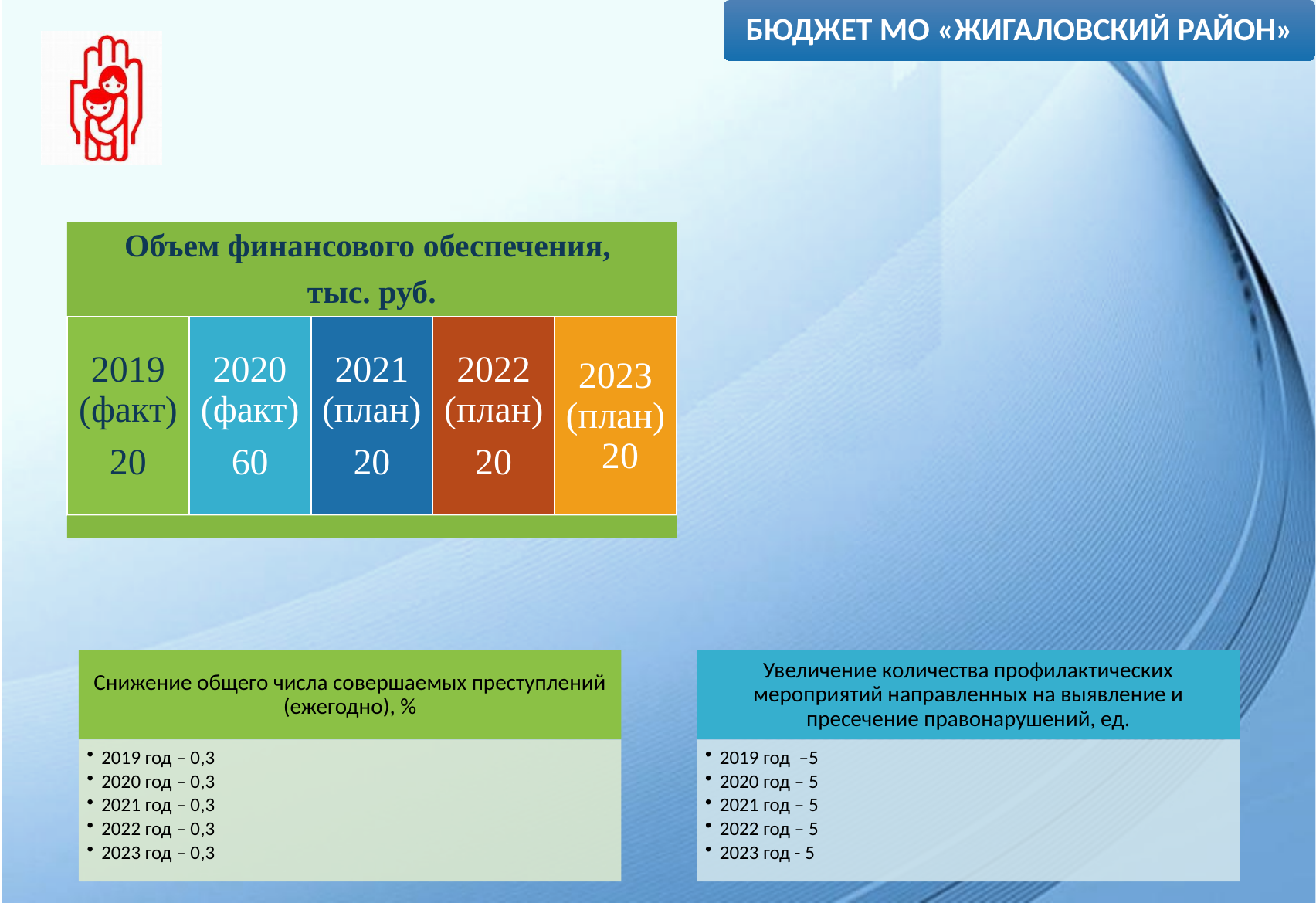
In the chart titled «Объем финансового обеспечения, тыс. руб.», what is the total of the values across all five years? 140 How many year categories are shown in the chart titled «Объем финансового обеспечения, тыс. руб.»? 5 In the chart titled «Объем финансового обеспечения, тыс. руб.», what is the value for 2020 (факт)? 60 In the chart titled «Объем финансового обеспечения, тыс. руб.», what is the difference between the values for 2020 (факт) and 2021 (план)? 40 In the chart titled «Объем финансового обеспечения, тыс. руб.», which is larger: the value for 2020 (факт) or the value for 2022 (план)? 2020 (факт) In the chart titled «Объем финансового обеспечения, тыс. руб.», how many years are marked as (план)? 3 In the chart titled «Объем финансового обеспечения, тыс. руб.», what is the value for 2023 (план)? 20 In the chart titled «Объем финансового обеспечения, тыс. руб.», what colour is the 2021 (план) block? Dark blue In the chart titled «Объем финансового обеспечения, тыс. руб.», what unit is stated in the title? тыс. руб. In the chart titled «Объем финансового обеспечения, тыс. руб.», which year has the highest value? 2020 (факт) In the chart titled «Объем финансового обеспечения, тыс. руб.», what is the value for 2019 (факт)? 20